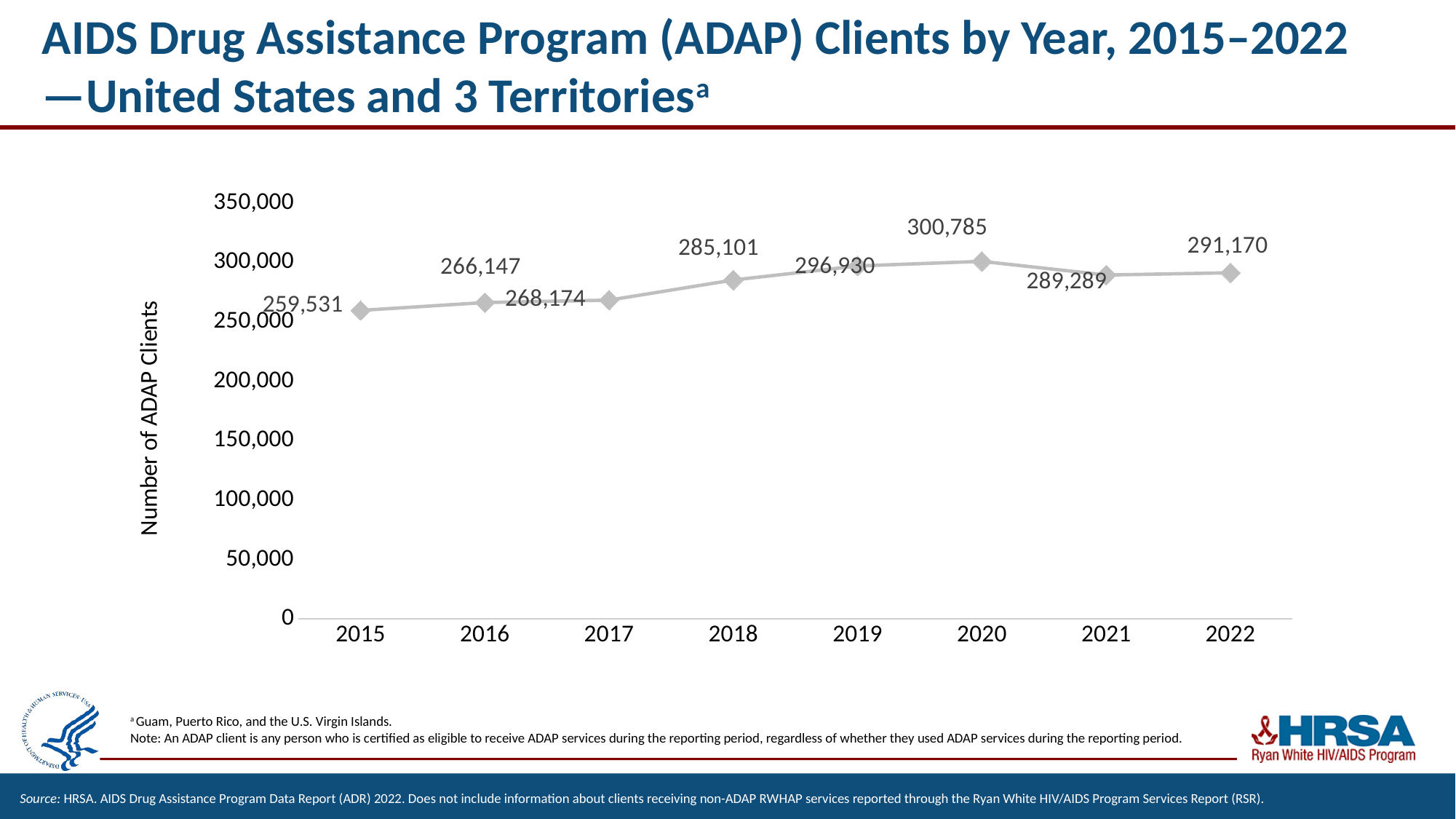
What type of chart is shown on the slide? line chart How many years are plotted on the chart? 8 What is the number of ADAP clients shown for 2022? 291,170 By how much did the number of ADAP clients increase from 2017 to 2018? 16,927 Which year has the highest number of ADAP clients? 2020 What is the label of the vertical axis? Number of ADAP Clients What is the difference in the number of ADAP clients between 2020 and 2015? 41,254 How many ADAP clients were there in 2015? 259,531 What is the number of ADAP clients shown for 2020? 300,785 Which year had more ADAP clients, 2019 or 2021? 2019 Which year has the lowest number of ADAP clients? 2015 Is the number of ADAP clients in 2018 greater or less than 300,000? less